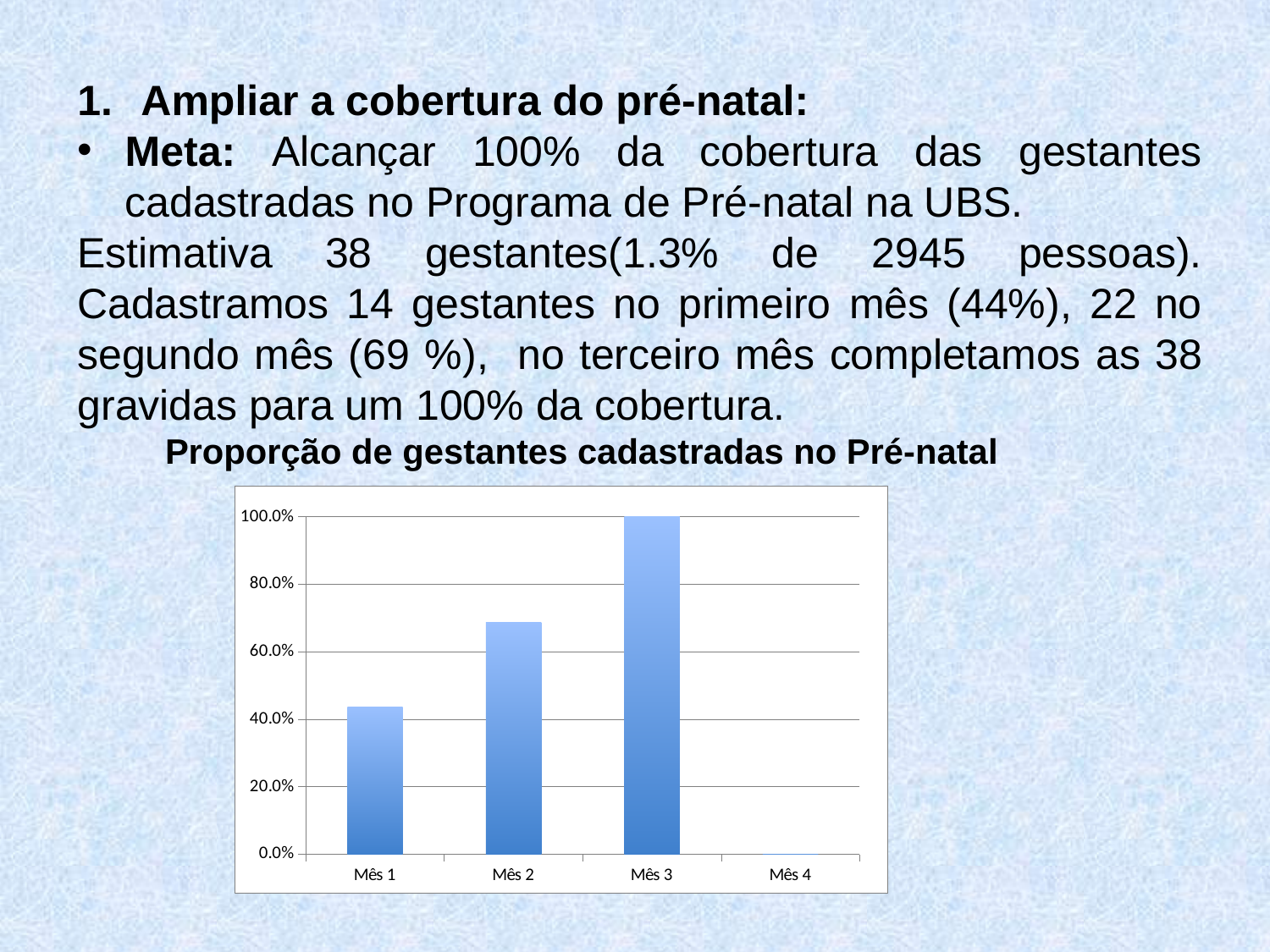
Is the value for Mês 1 greater or less than 40.0%? greater Is the value for Mês 1 greater or less than 60.0%? less What type of chart is shown on the slide? bar chart What is the title of the chart? Proporção de gestantes cadastradas no Pré-natal Is the value for Mês 2 greater or less than 60.0%? greater What value does the bar for Mês 3 reach on the y axis? 100.0% How many categories are shown on the x axis of the chart? 4 What is the highest tick label shown on the y axis of the chart? 100.0% Do the values rise or fall from Mês 1 to Mês 3? rise Which is larger, the value for Mês 1 or the value for Mês 2? Mês 2 Which month has the highest bar in the chart? Mês 3